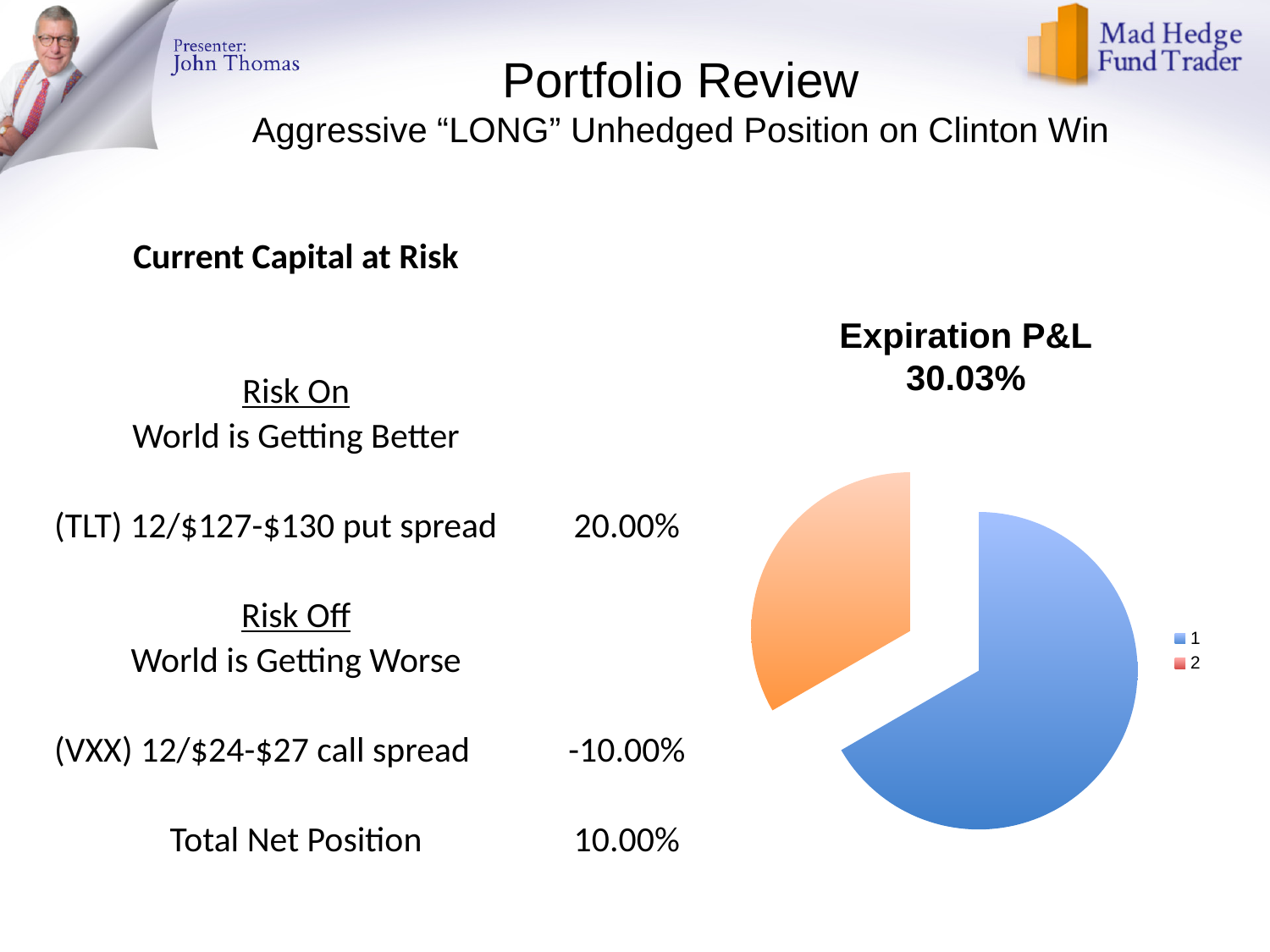
What colour is slice 1 in the pie chart? blue How many slices does the pie chart have? 2 Does slice 1 of the pie chart take up more or less than half of the pie? more How many entries does the pie chart's legend list? 2 What is the title of the pie chart? Expiration P&L 30.03% What are the labels listed in the pie chart's legend? 1 and 2 In the pie chart, which slice is larger, 1 or 2? 1 Which slice of the pie chart is the largest? 1 Which slice of the pie chart is the smallest? 2 What kind of chart is shown on the slide? pie chart